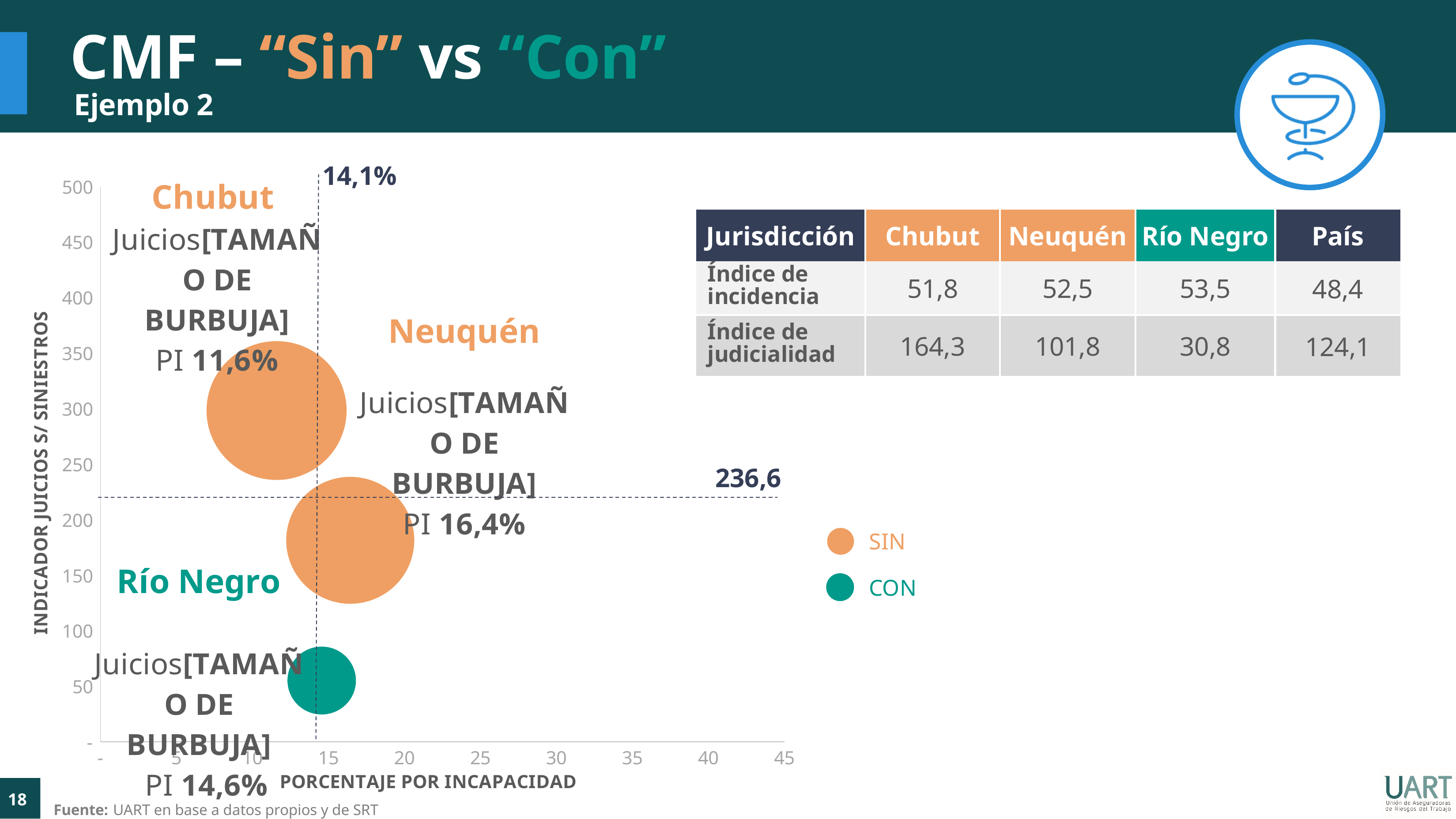
Which jurisdiction has the lowest labelled PI value? Chubut Which jurisdiction has the highest labelled PI value? Neuquén What is the difference between the PI values of Neuquén and Chubut? 4,8 percentage points How many series does the chart legend list? 2 What is the PI value labelled for Neuquén? 16,4% What is the PI (porcentaje por incapacidad) value labelled for Chubut? 11,6% Is the Indicador Juicios s/ Siniestros value for Chubut greater or less than 250? greater What value is labelled on the horizontal dashed reference line of the chart? 236,6 What kind of chart is shown on the slide? Bubble chart How many bubbles (jurisdictions) are plotted on the chart? 3 What is the PI value labelled for Río Negro? 14,6% Is the Indicador Juicios s/ Siniestros value for Río Negro greater or less than 100? less